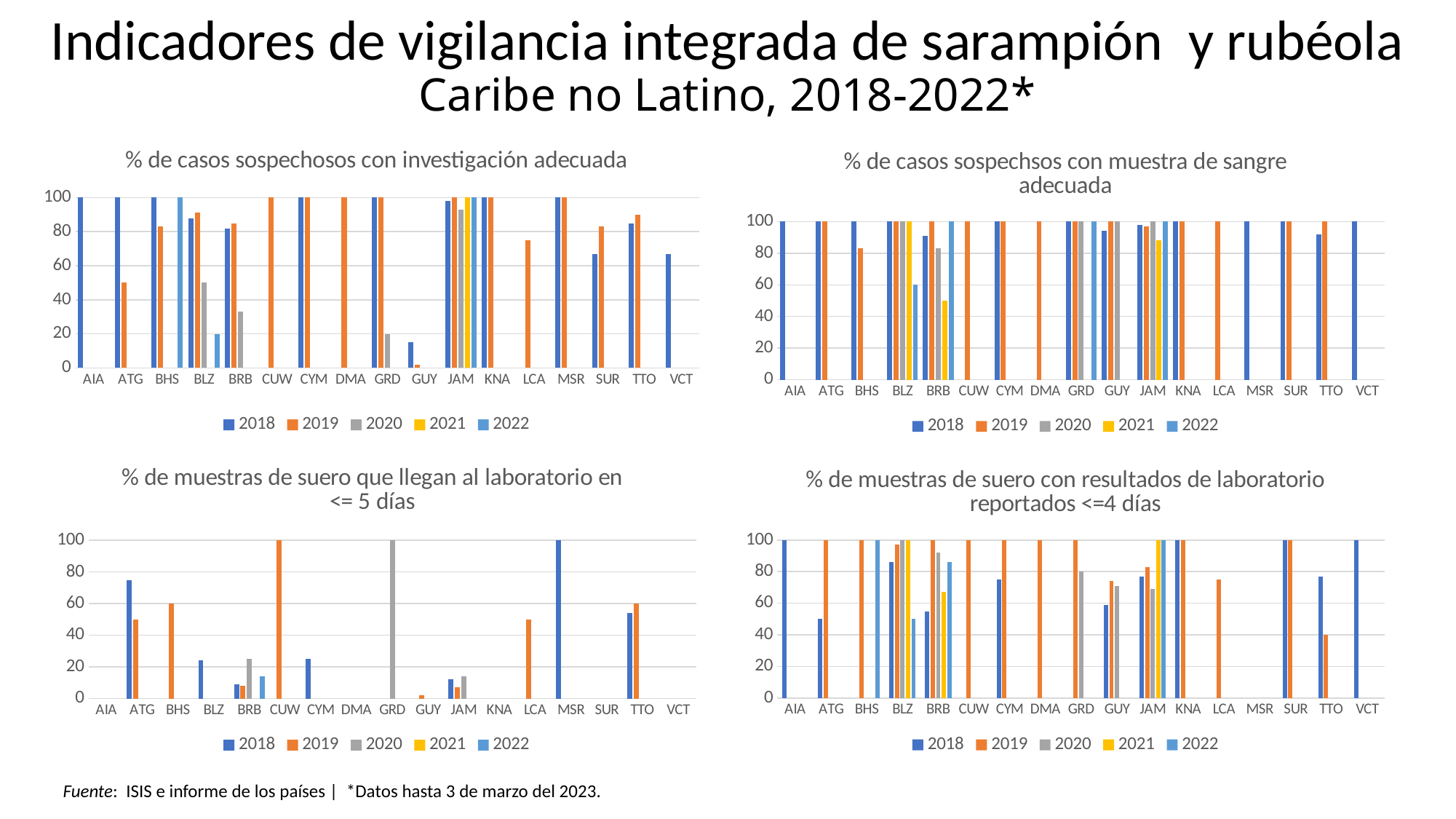
In the chart '% de casos sospechsos con muestra de sangre adecuada', is the value for BRB in 2020 greater or less than 60? greater In the chart '% de casos sospechosos con investigación adecuada', is the value for BRB in 2020 greater or less than 40? less How many charts are shown on the slide? 4 In the chart '% de muestras de suero con resultados de laboratorio reportados <=4 días', is the value for GUY in 2019 greater or less than 60? greater Which year is represented by the yellow bars in the legend of the chart '% de casos sospechosos con investigación adecuada'? 2021 What kind of chart is '% de casos sospechosos con investigación adecuada'? bar chart How many countries are shown on the x axis of the chart '% de casos sospechsos con muestra de sangre adecuada'? 17 How many series does the legend list in the chart '% de muestras de suero que llegan al laboratorio en <= 5 días'? 5